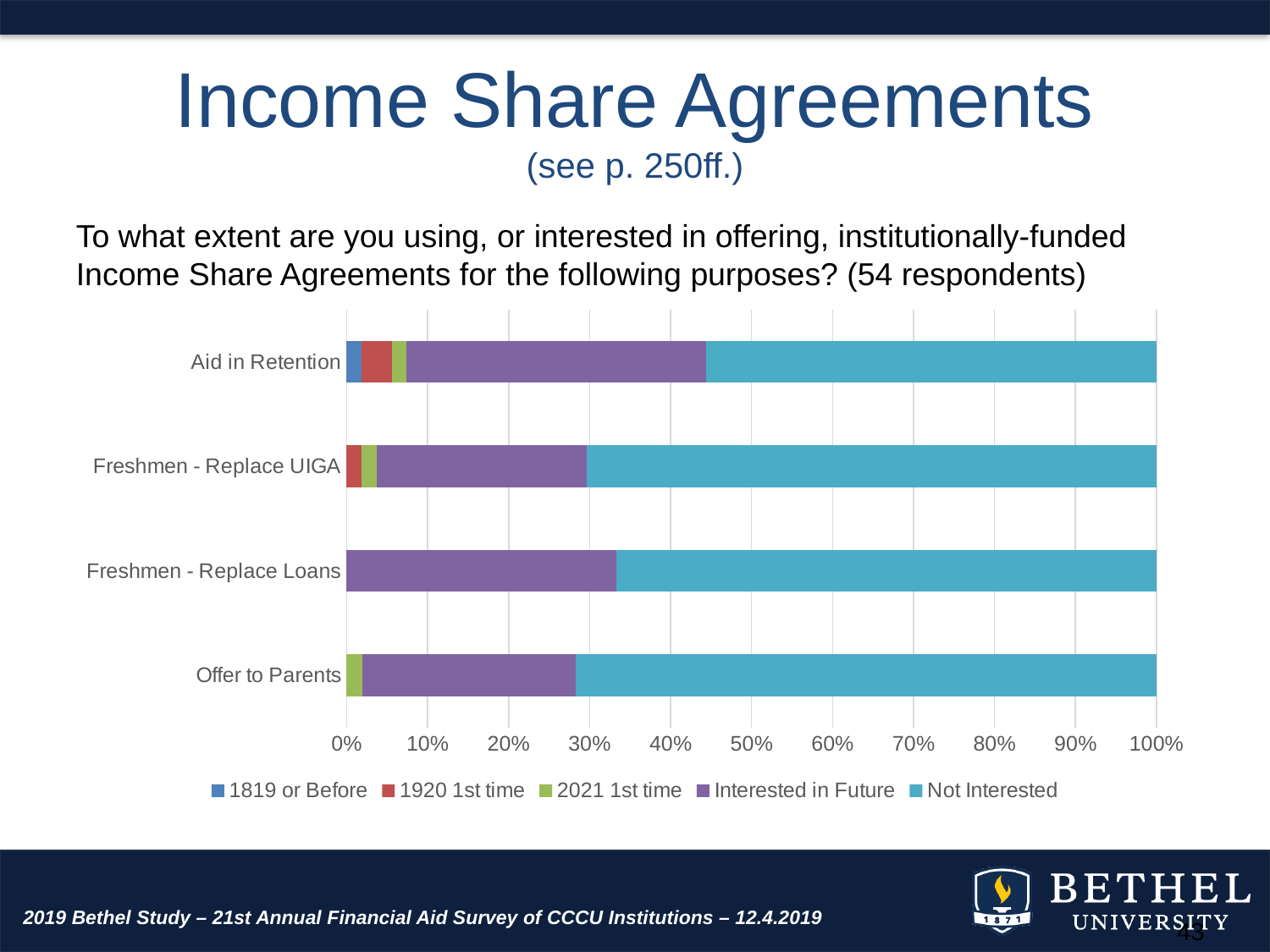
What kind of chart is shown on the slide? Stacked bar chart Is the Not Interested value for Aid in Retention greater or less than 50%? greater Which category has the largest Interested in Future segment? Aid in Retention How many series does the legend list? 5 Is the Not Interested value for Freshmen - Replace Loans greater or less than 60%? greater Which category has the smallest Not Interested segment? Aid in Retention How many categories (purposes) are plotted on the chart? 4 Is the Not Interested segment larger for Freshmen - Replace Loans or for Aid in Retention? Freshmen - Replace Loans Which category is the only one with an 1819 or Before segment? Aid in Retention What is the total of the stacked bar for Offer to Parents? 100% Is the Interested in Future value for Offer to Parents greater or less than 30%? less